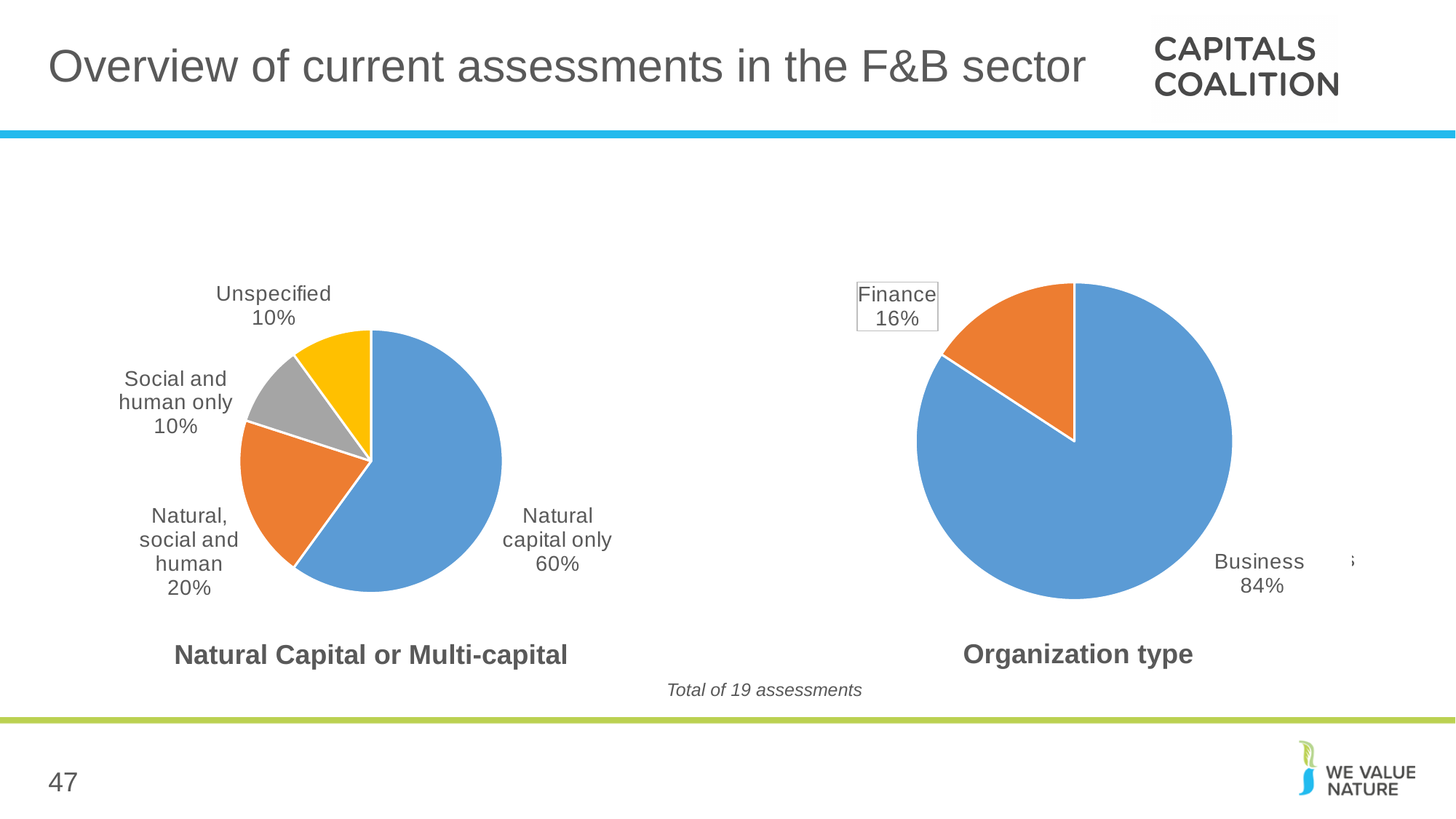
What kind of chart is the 'Organization type' chart? Pie chart In the 'Natural Capital or Multi-capital' chart, what share is 'Natural, social and human'? 20% In the 'Natural Capital or Multi-capital' chart, which category has the largest share? Natural capital only In the 'Natural Capital or Multi-capital' chart, what share is 'Social and human only'? 10% In the 'Natural Capital or Multi-capital' chart, how many slices does the pie have? 4 In the 'Organization type' chart, what share is 'Finance'? 16% In the 'Natural Capital or Multi-capital' chart, what share is 'Natural capital only'? 60% In the 'Organization type' chart, what share is 'Business'? 84% In the 'Organization type' chart, which category has the smallest share? Finance In the 'Organization type' chart, how many slices does the pie have? 2 In the 'Natural Capital or Multi-capital' chart, what is the difference between 'Natural capital only' and 'Natural, social and human'? 40% According to the note below the charts, how many assessments are included in total? 19